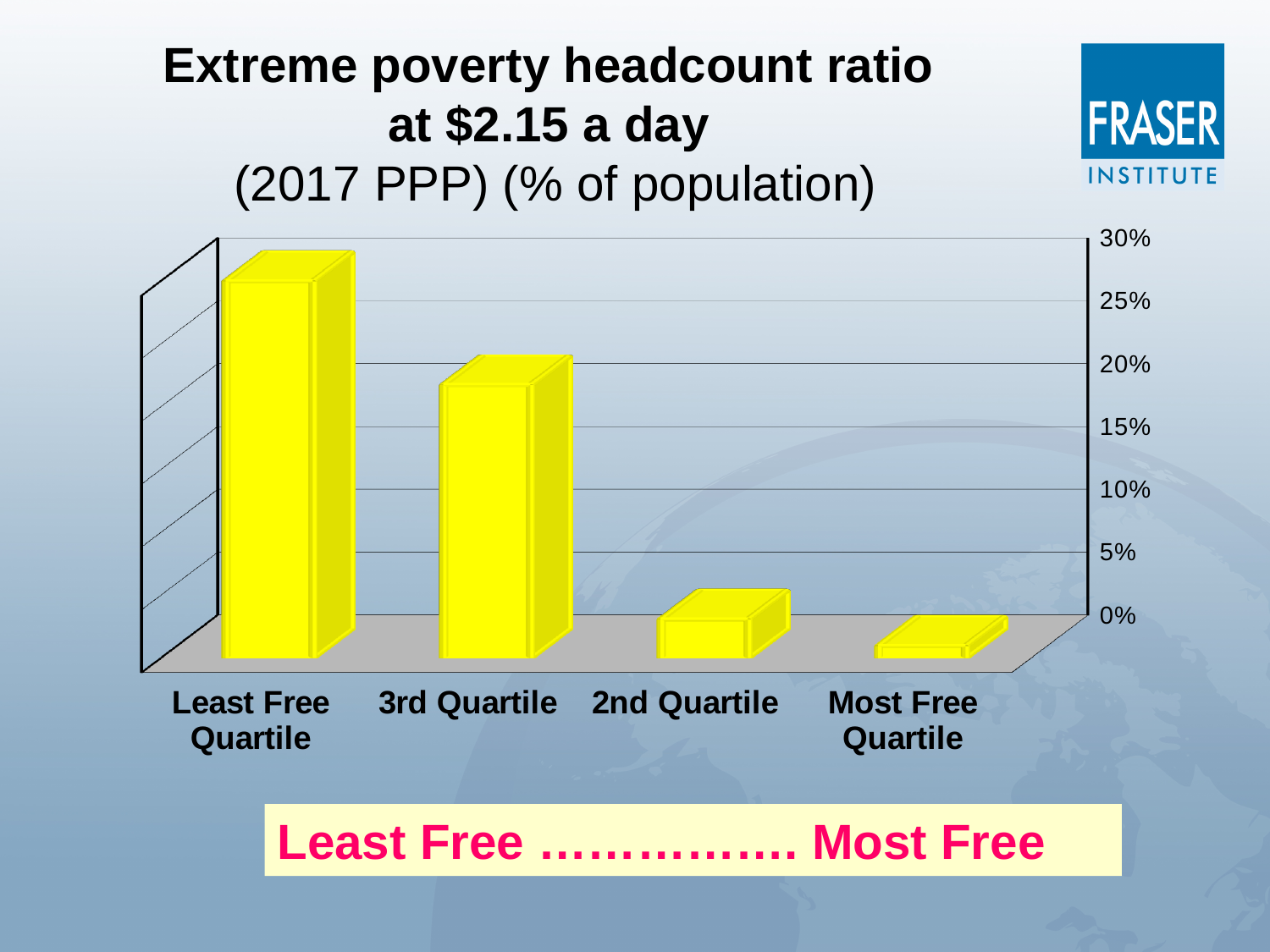
Which quartile has the lowest extreme poverty headcount ratio? Most Free Quartile Is the value for the Least Free Quartile greater or less than 25%? greater Do the values rise or fall moving from the Least Free Quartile to the Most Free Quartile? Fall What is the title of the chart? Extreme poverty headcount ratio at $2.15 a day (2017 PPP) (% of population) Which quartile has the highest extreme poverty headcount ratio? Least Free Quartile What kind of chart is shown on the slide? Bar chart Which has a higher extreme poverty headcount ratio, the 2nd Quartile or the Most Free Quartile? 2nd Quartile Is the value for the 3rd Quartile greater or less than 15%? greater How many quartile categories are plotted on the chart? 4 Is the value for the Most Free Quartile greater or less than 5%? less